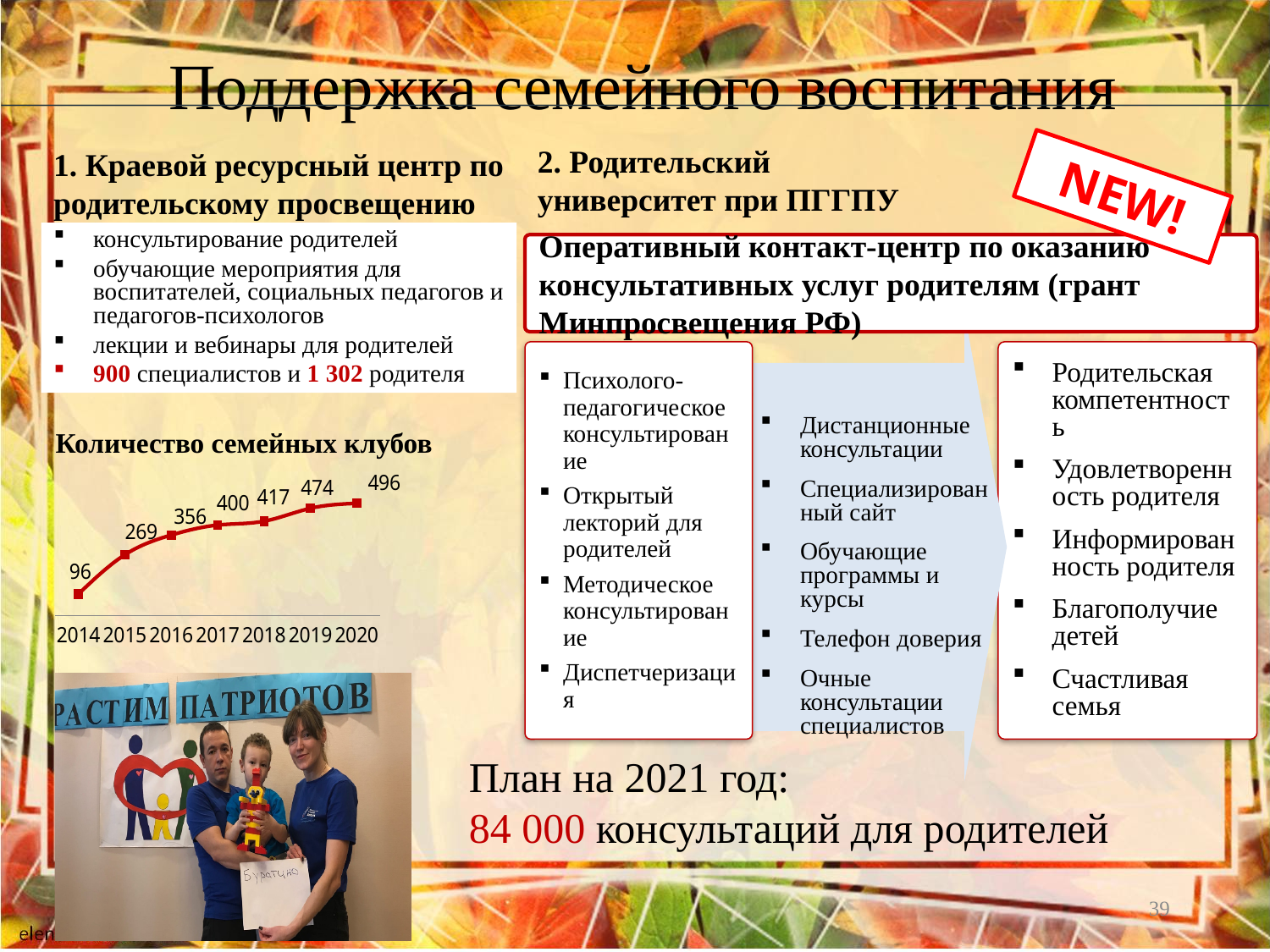
How many years are plotted in the 'Количество семейных клубов' chart? 7 What is the value for 2017 in the 'Количество семейных клубов' chart? 400 What is the title of the line chart on the slide? Количество семейных клубов Which is larger in the 'Количество семейных клубов' chart: the value for 2016 or the value for 2018? 2018 Which year has the lowest value in the 'Количество семейных клубов' chart? 2014 What is the value for 2020 in the 'Количество семейных клубов' chart? 496 What is the difference between the values for 2020 and 2019 in the 'Количество семейных клубов' chart? 22 What type of chart is used to show 'Количество семейных клубов'? line chart Which year has the highest value in the 'Количество семейных клубов' chart? 2020 What is the value for 2014 in the 'Количество семейных клубов' chart? 96 Do the values in the 'Количество семейных клубов' chart rise or fall from 2014 to 2020? rise What is the difference between the values for 2015 and 2014 in the 'Количество семейных клубов' chart? 173